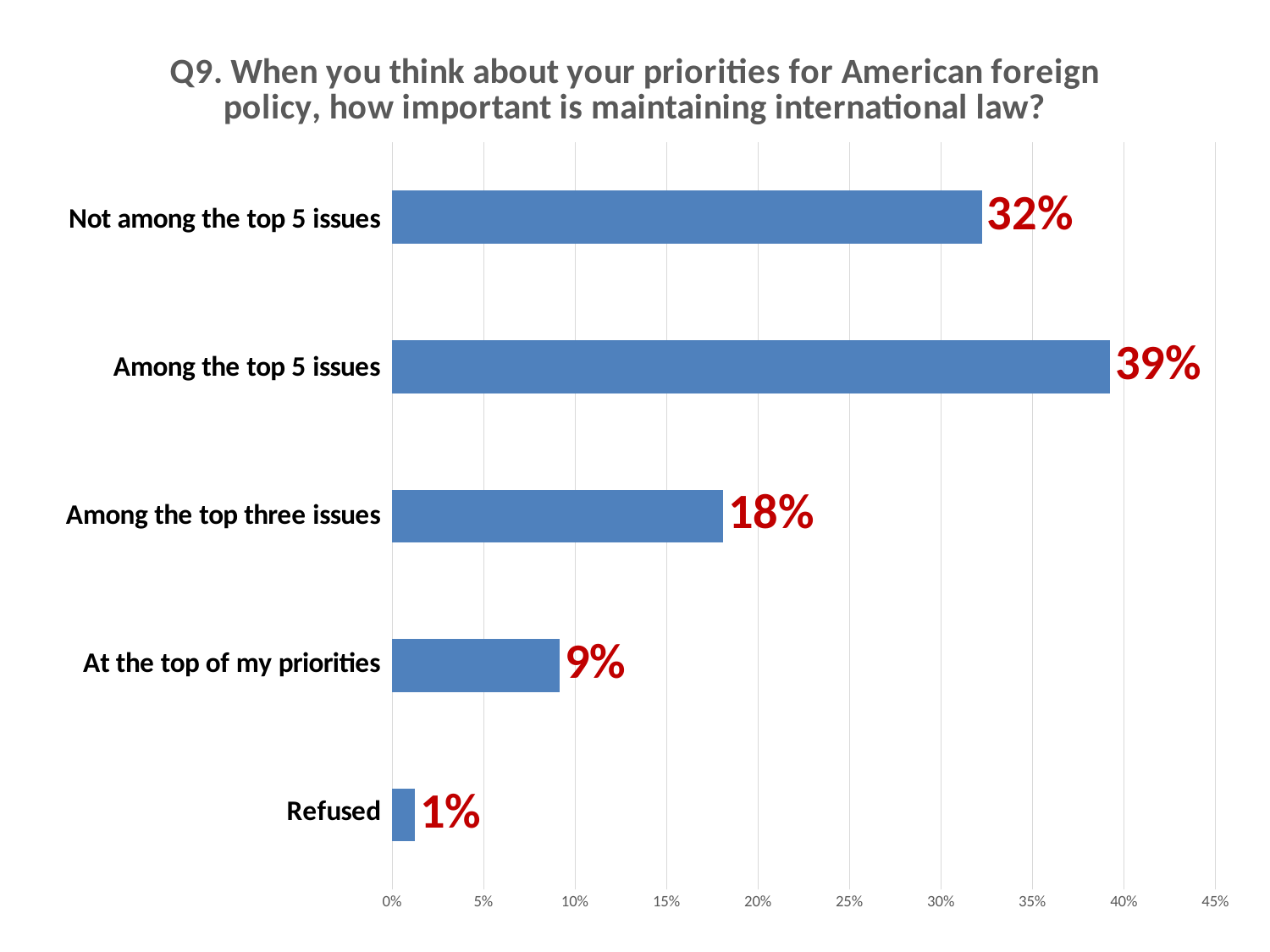
What percentage of respondents refused to answer? 1% What is the value for "At the top of my priorities"? 9% What is the difference between "Among the top three issues" and "At the top of my priorities"? 9% How many categories are shown in the chart? 5 Which category has the highest value? Among the top 5 issues What percentage of respondents said maintaining international law is among the top 5 issues? 39% Which category has the lowest value? Refused What is the difference between "Among the top 5 issues" and "Not among the top 5 issues"? 7% What kind of chart is shown on the slide? Bar chart Is the value for "Among the top three issues" greater or less than 20%? less What is the highest value shown on the x axis? 45% Which is larger: "Not among the top 5 issues" or "Among the top three issues"? Not among the top 5 issues